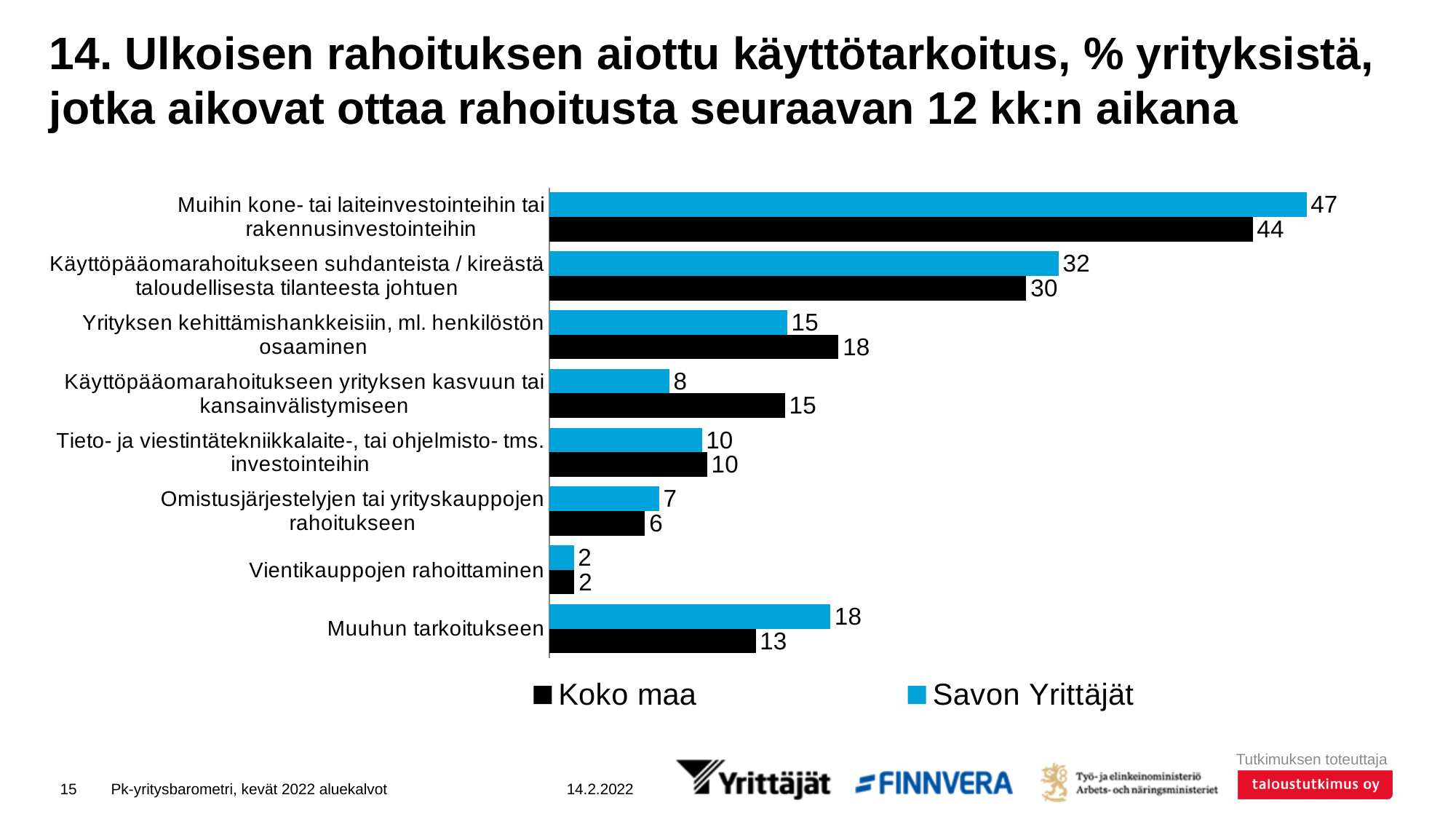
How many categories are shown on the chart? 8 How many series does the legend list? 2 Which colour represents Savon Yrittäjät in the chart? Blue What is the value for Savon Yrittäjät for 'Muihin kone- tai laiteinvestointeihin tai rakennusinvestointeihin'? 47 What kind of chart is shown on the slide? Bar chart Which category has the lowest value for Koko maa? Vientikauppojen rahoittaminen Which category has the highest value for Savon Yrittäjät? Muihin kone- tai laiteinvestointeihin tai rakennusinvestointeihin What is the value for Koko maa for 'Käyttöpääomarahoitukseen suhdanteista / kireästä taloudellisesta tilanteesta johtuen'? 30 For 'Yrityksen kehittämishankkeisiin, ml. henkilöstön osaaminen', which series has the larger value, Koko maa or Savon Yrittäjät? Koko maa What is the difference between the Koko maa and Savon Yrittäjät values for 'Käyttöpääomarahoitukseen yrityksen kasvuun tai kansainvälistymiseen'? 7 For 'Muuhun tarkoitukseen', which series has the larger value, Koko maa or Savon Yrittäjät? Savon Yrittäjät What is the value for Koko maa for 'Muuhun tarkoitukseen'? 13